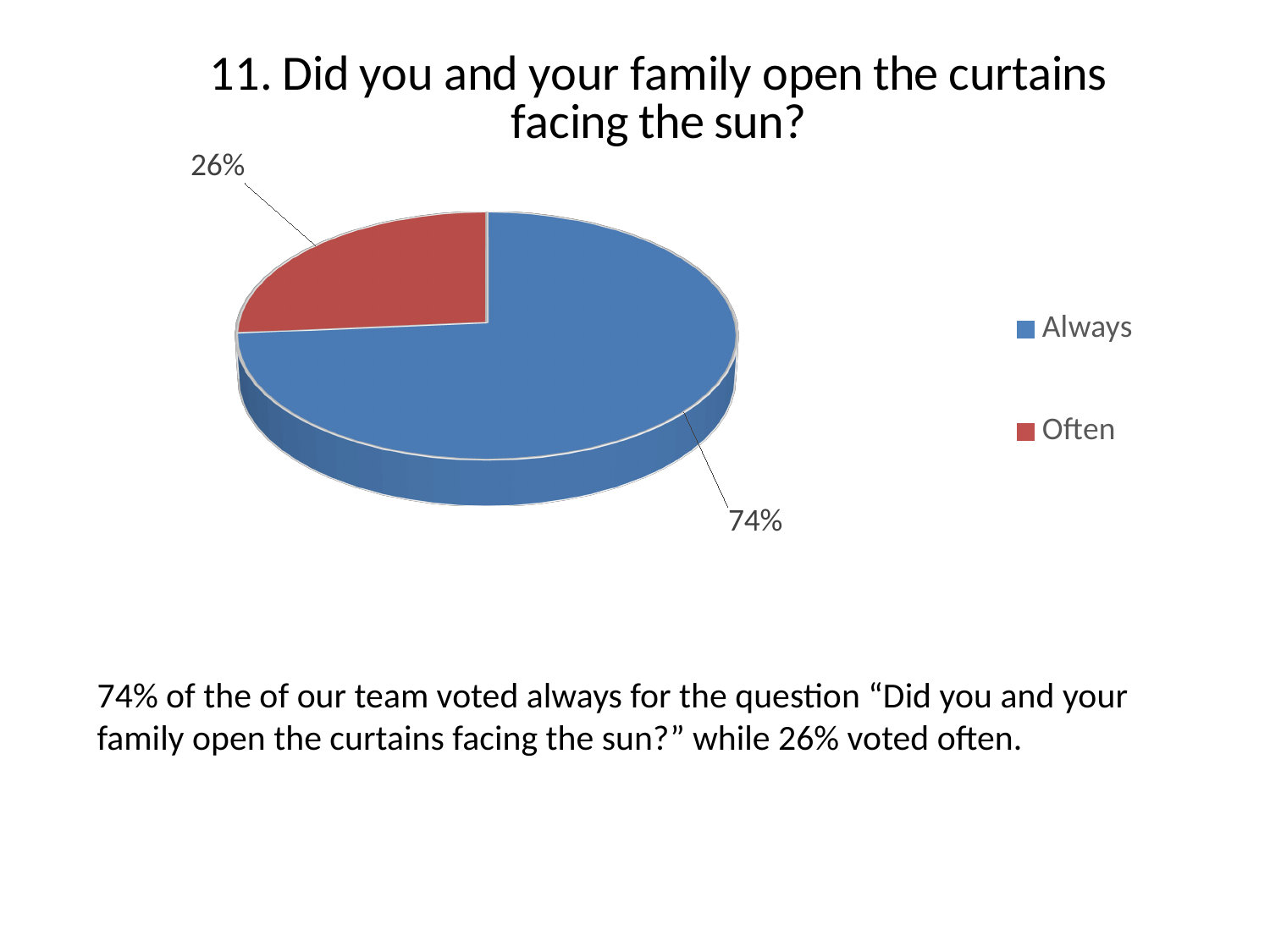
What kind of chart is shown on the slide? Pie chart What is the difference in percentage points between the Always and Often slices? 48 Which category has the smallest slice of the pie? Often What is the title of the chart? 11. Did you and your family open the curtains facing the sun? What share of the pie does the Often slice represent? 26% What share of the pie does the Always slice represent? 74% Which category has the largest slice of the pie? Always How many categories are shown in the pie chart? 2 Which is larger, the Always slice or the Often slice? Always What colour is the Often slice? Red How many entries does the legend list? 2